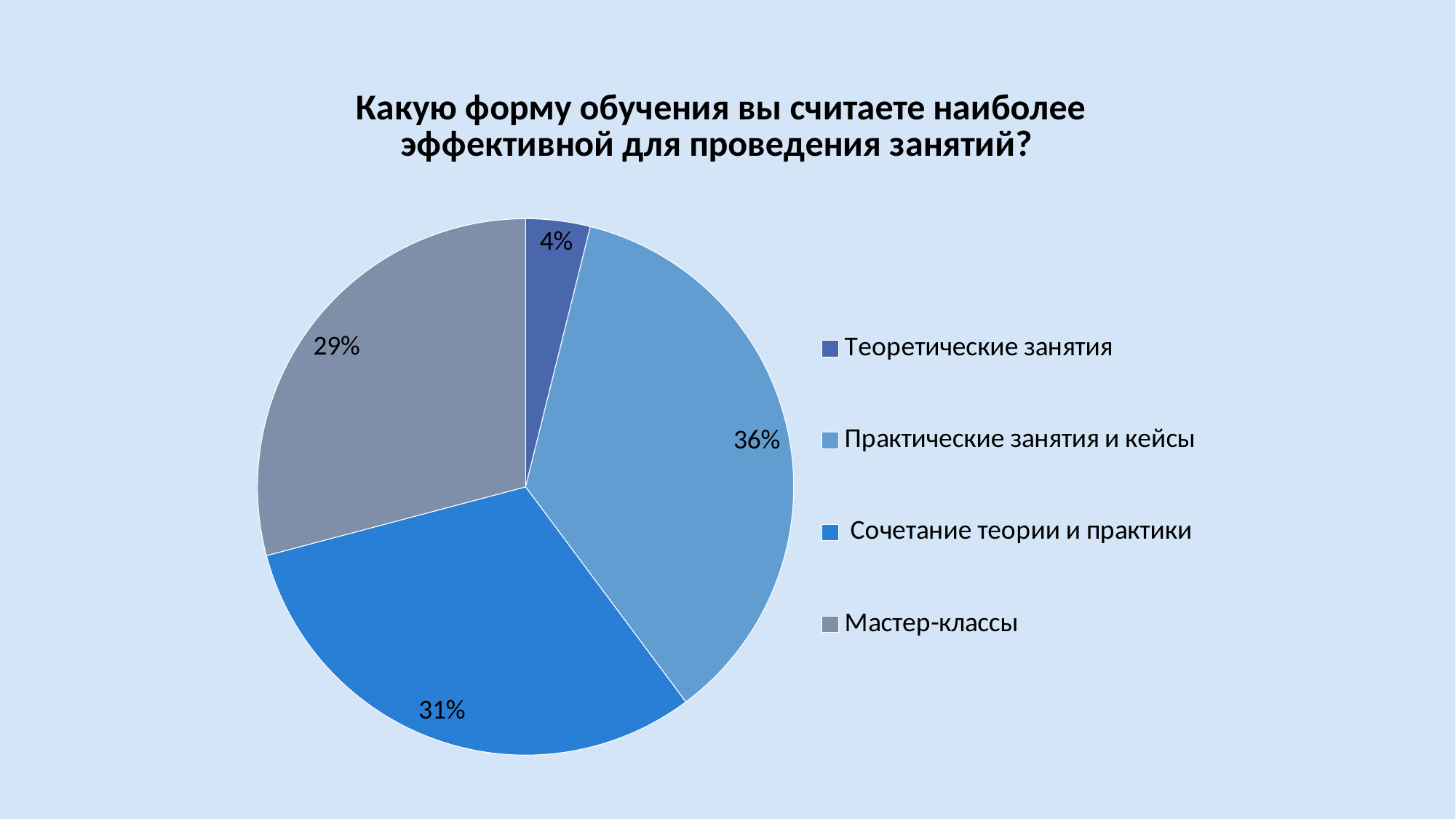
Which legend entry is shown in grey? Мастер-классы What is the difference in percentage points between "Практические занятия и кейсы" and "Мастер-классы"? 7 What is the title of the chart? Какую форму обучения вы считаете наиболее эффективной для проведения занятий? How many categories does the pie chart have? 4 Which category has the largest slice? Практические занятия и кейсы Which is larger: "Сочетание теории и практики" or "Мастер-классы"? Сочетание теории и практики What share of the pie does "Мастер-классы" have? 29% What share of the pie does "Практические занятия и кейсы" have? 36% What share of the pie does "Сочетание теории и практики" have? 31% Which category has the smallest slice? Теоретические занятия What type of chart is shown on the slide? Pie chart